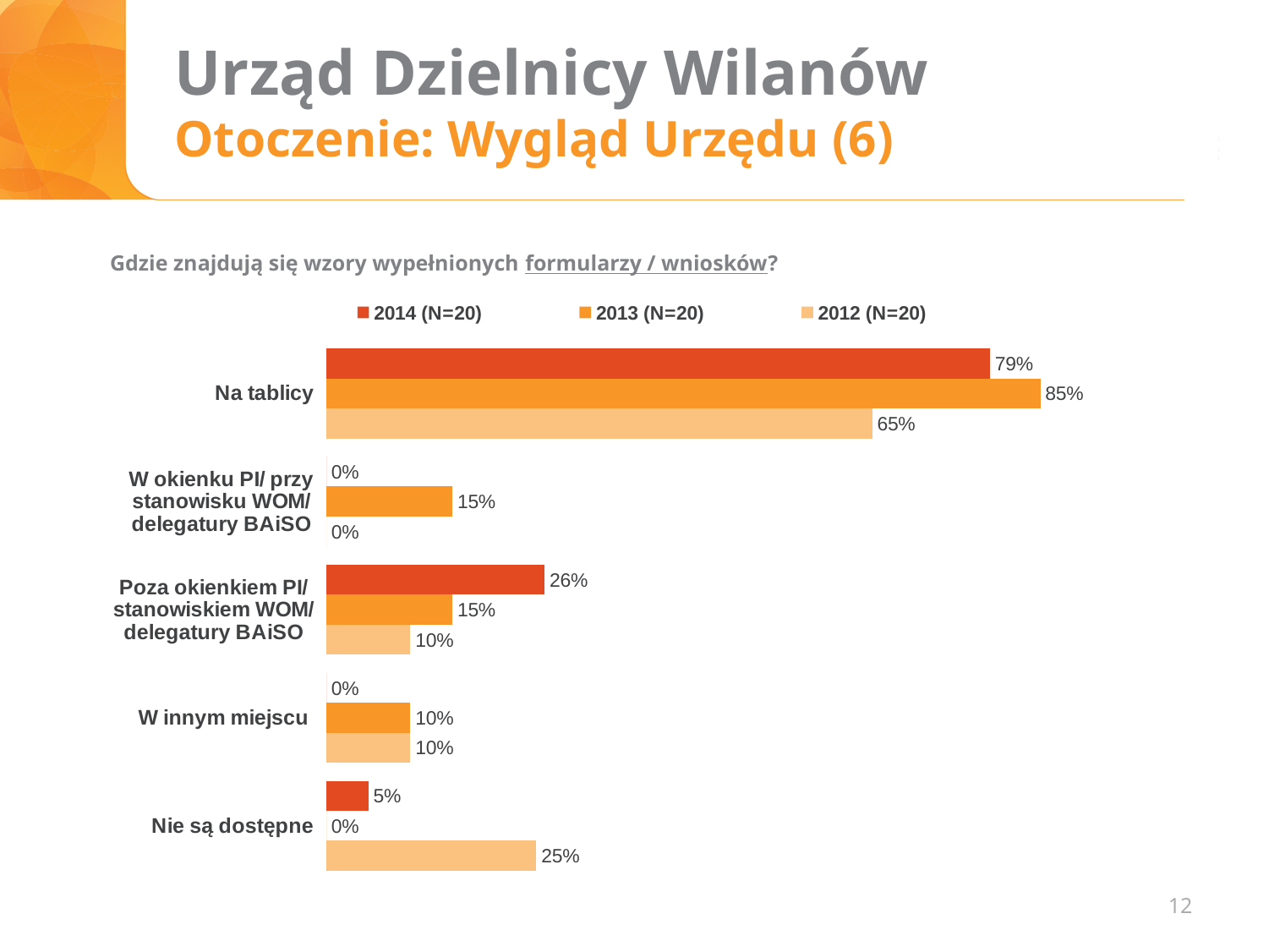
What is the value for "Na tablicy" in the 2013 (N=20) series? 85% Which category has the lowest value in the 2012 (N=20) series? W okienku PI/ przy stanowisku WOM/ delegatury BAiSO What kind of chart is shown on the slide? bar chart Which is larger for "Nie są dostępne": the 2014 (N=20) value or the 2012 (N=20) value? 2012 (N=20) What is the value for "Poza okienkiem PI/ stanowiskiem WOM/ delegatury BAiSO" in the 2014 (N=20) series? 26% Which series is shown in the lightest orange colour in the legend? 2012 (N=20) How many categories are shown on the chart? 5 Which category has the highest value in the 2014 (N=20) series? Na tablicy What is the value for "Na tablicy" in the 2012 (N=20) series? 65% What is the difference between the 2013 (N=20) and 2014 (N=20) values for "Na tablicy"? 6% What is the value for "Nie są dostępne" in the 2012 (N=20) series? 25% How many series does the legend list? 3